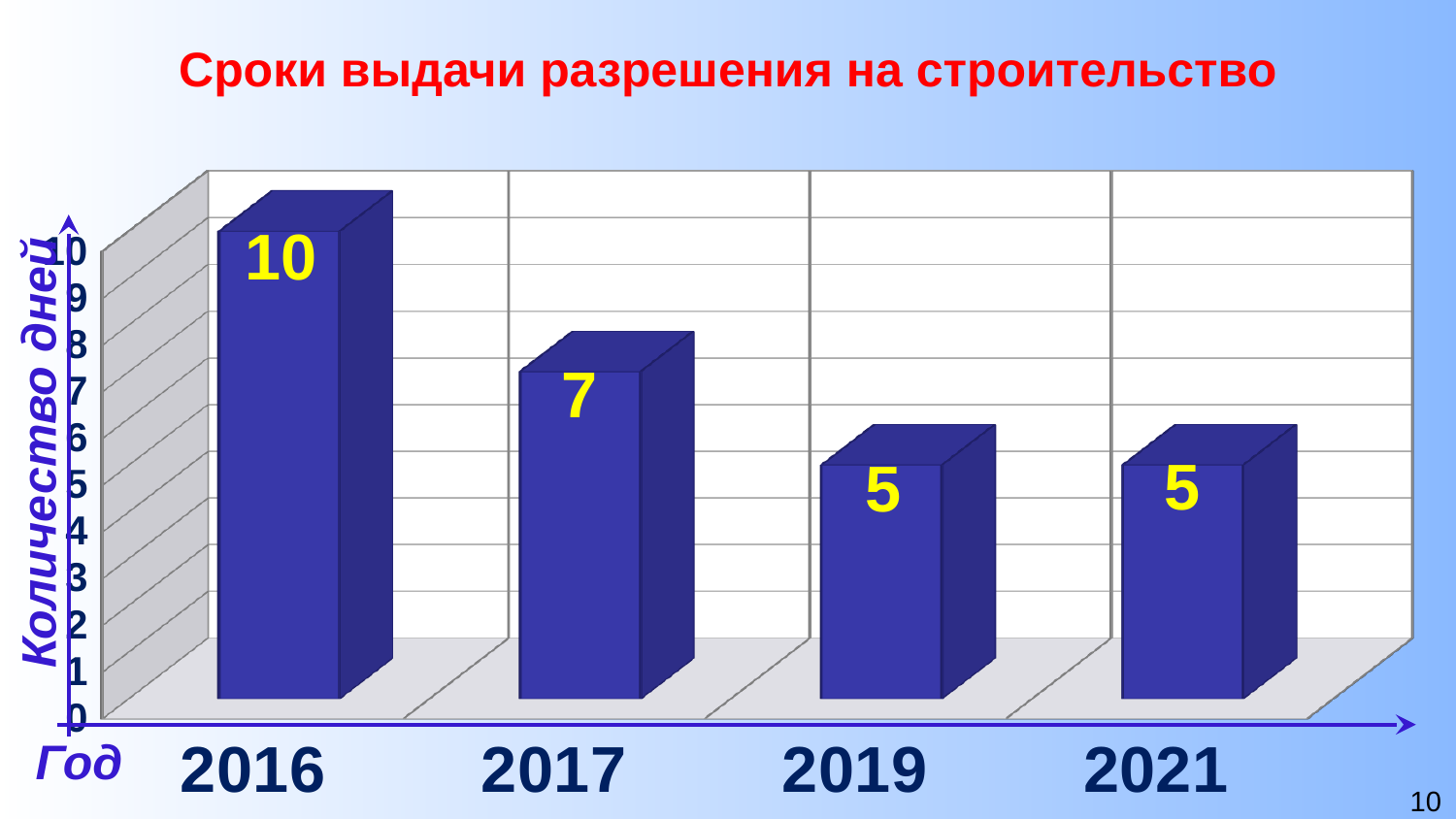
What is the title of the chart? Сроки выдачи разрешения на строительство What is the value for 2017? 7 What is the value for 2016? 10 What is the difference between the values for 2016 and 2021? 5 How many years are shown on the x axis? 4 Which is larger, the value for 2017 or the value for 2019? 2017 Which year has the highest value? 2016 Do the values rise or fall from 2016 to 2019? fall What is the value for 2019? 5 What is the difference between the values for 2016 and 2017? 3 Is the value for 2017 greater or less than 5? greater What kind of chart is shown on the slide? bar chart